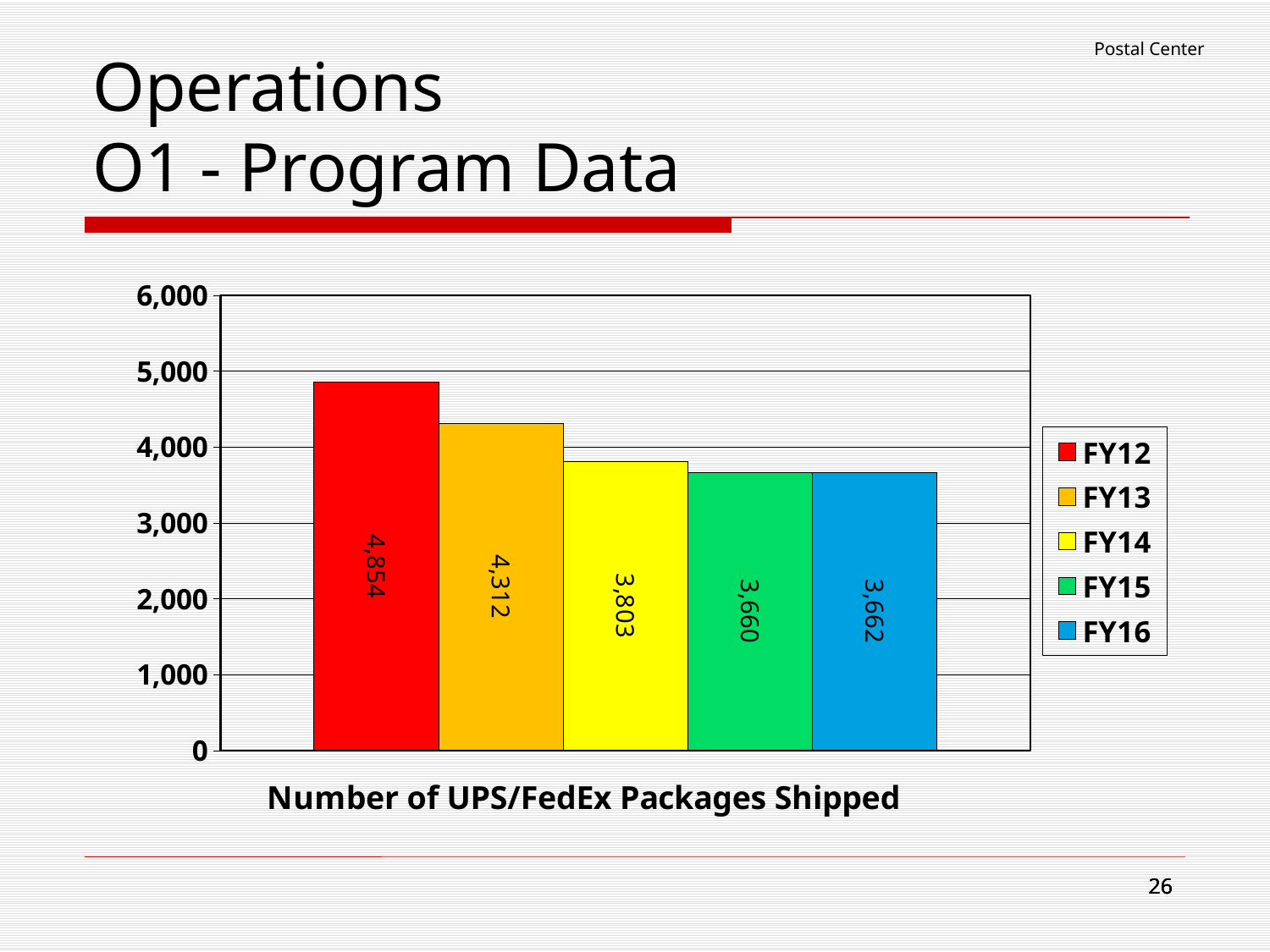
What is the title shown below the chart? Number of UPS/FedEx Packages Shipped Which is larger, the number of packages shipped in FY13 or in FY14? FY13 What is the difference between the number of packages shipped in FY12 and FY13? 542 What is the number of UPS/FedEx packages shipped in FY12? 4,854 What is the number of UPS/FedEx packages shipped in FY16? 3,662 Which fiscal year has the highest number of UPS/FedEx packages shipped? FY12 What is the number of UPS/FedEx packages shipped in FY14? 3,803 What kind of chart is shown on the slide? bar chart What is the difference between the number of packages shipped in FY13 and FY14? 509 Which fiscal year has the lowest number of UPS/FedEx packages shipped? FY15 Is the value for FY12 greater or less than 4,000? greater How many fiscal years are shown in the chart? 5